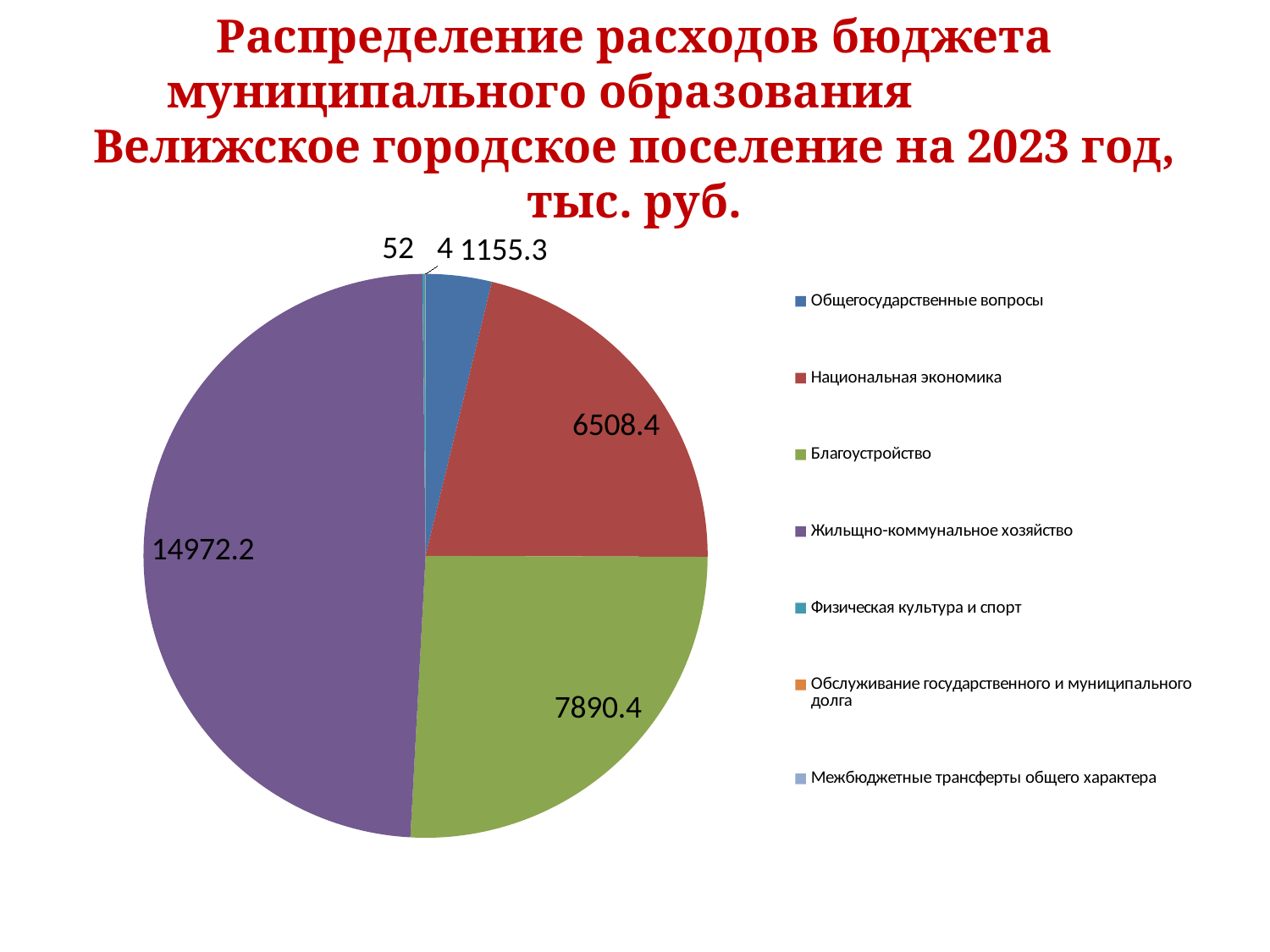
What is the value for Национальная экономика in the pie chart? 6508.4 What is the difference between the values for Жильщно-коммунальное хозяйство and Благоустройство? 7081.8 What kind of chart is shown on the slide? Pie chart How many categories does the legend of the pie chart list? 7 Which category has the largest slice in the pie chart? Жильщно-коммунальное хозяйство For which year does the chart title say the budget expenditures are distributed? 2023 What is the value for Жильщно-коммунальное хозяйство in the pie chart? 14972.2 What colour is the slice for Жильщно-коммунальное хозяйство? Purple What is the value for Общегосударственные вопросы in the pie chart? 1155.3 What is the value for Благоустройство in the pie chart? 7890.4 What is the difference between the values for Благоустройство and Национальная экономика? 1382 Which is larger: the value for Национальная экономика or the value for Благоустройство? Благоустройство